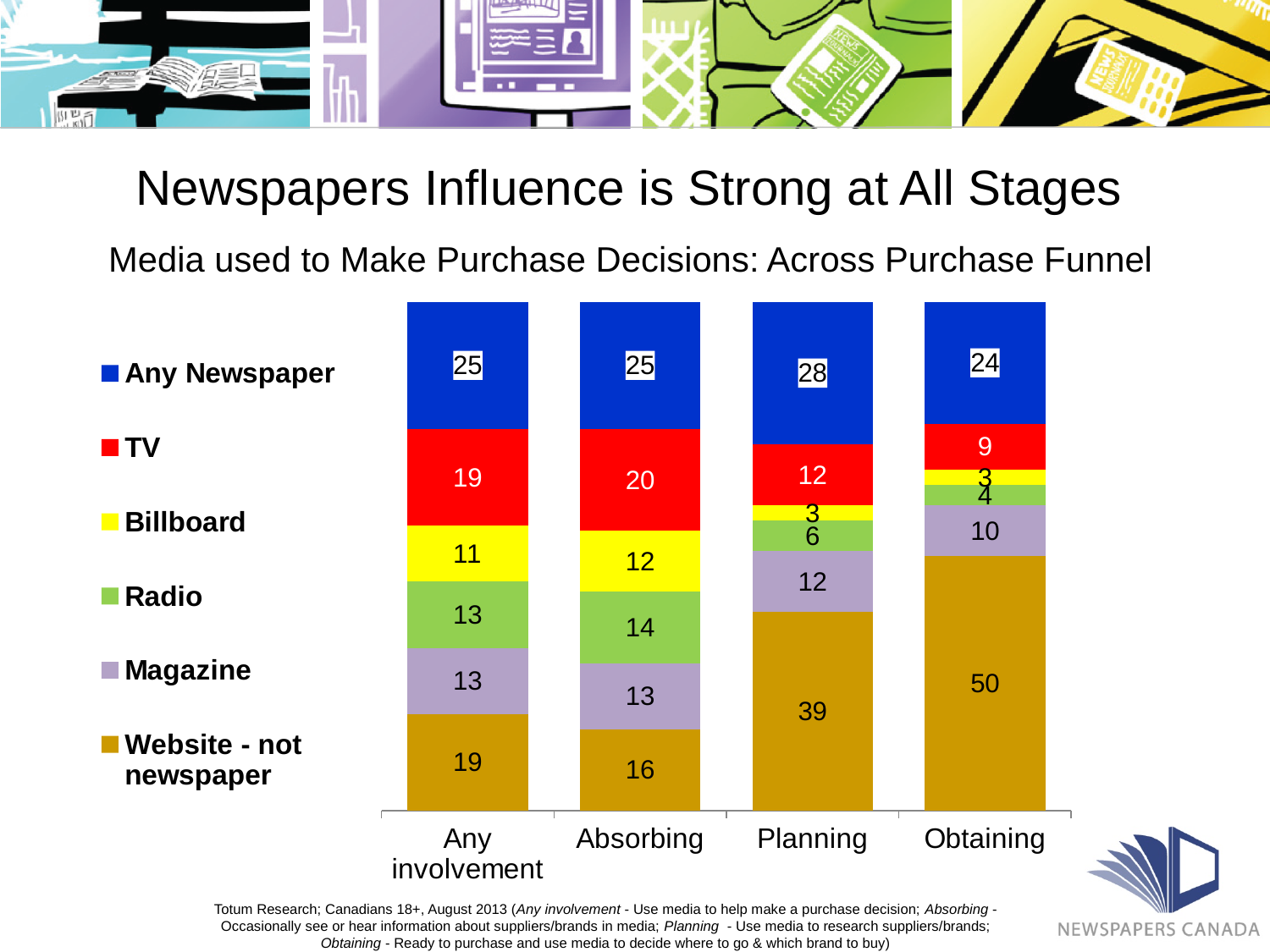
What is the value for Any Newspaper in the Planning category? 28 Which is larger: the Radio value for Absorbing or the Radio value for Planning? Absorbing How many categories are shown on the x axis? 4 In which category is the Website - not newspaper value highest? Obtaining What is the value for Billboard in the Any involvement category? 11 What is the total of the stacked bar for Planning? 100 What kind of chart is shown on the slide? Stacked bar chart How many series does the legend list? 6 What is the value for TV in the Absorbing category? 20 What is the difference between the Website - not newspaper values for Obtaining and Planning? 11 What is the value for Website - not newspaper in the Obtaining category? 50 In which category is the TV value lowest? Obtaining